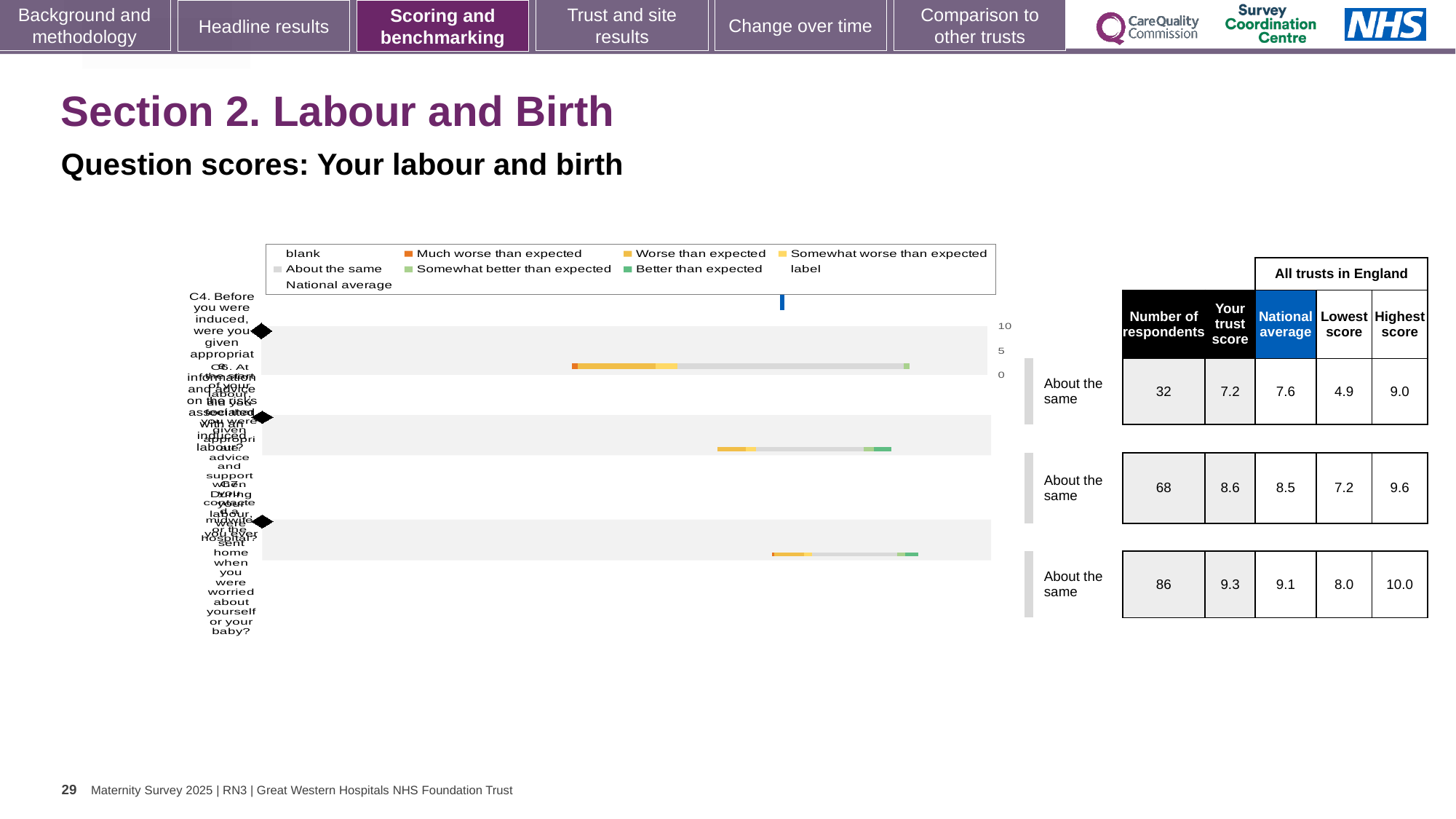
What is the number of respondents for the first (top) question row? 32 How many question rows (bars) are plotted in the chart? 3 Which question row has the highest trust score? The third (bottom) row, 9.3 What colour does the legend use for 'Better than expected'? Green Which question row has the lowest 'Lowest score' value? The first (top) row, 4.9 For the first (top) question row, which is larger: the trust score or the national average? National average (7.6) What does the legend call the blue line marker? National average What is the difference between the highest score and the lowest score for the third (bottom) question row? 2.0 What is the trust score for the second question row? 8.6 What kind of chart is shown on the slide? Bar chart What benchmark category is shown for all three question rows? About the same What is the national average for the third (bottom) question row? 9.1